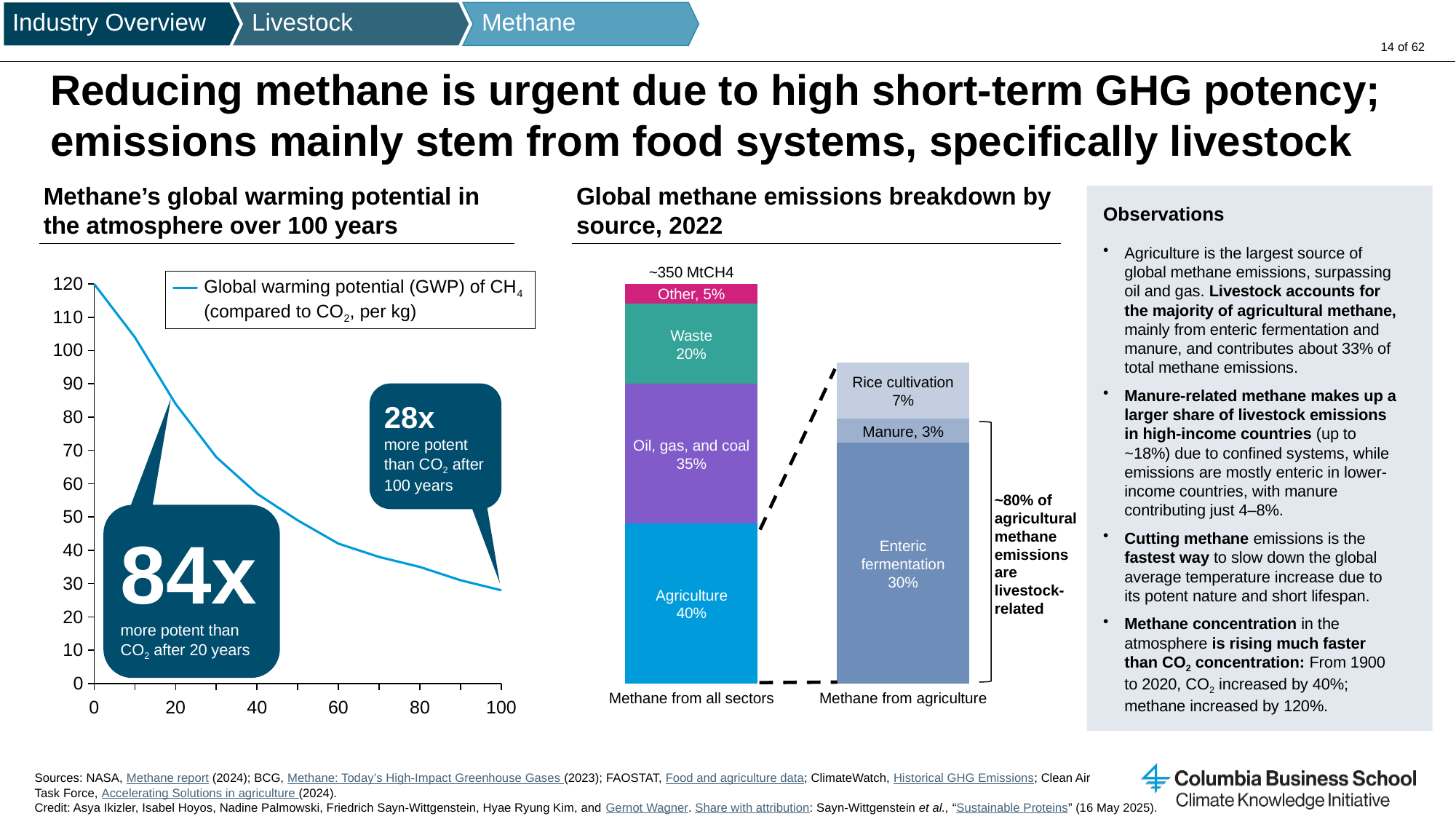
What kind of chart is the right chart, 'Global methane emissions breakdown by source, 2022'? Stacked bar chart In the right chart, which source is the largest segment of the 'Methane from all sectors' bar? Agriculture In the left chart, is the global warming potential at year 60 greater or less than 50? less In the right chart, what share of methane from all sectors comes from agriculture? 40% In the right chart, which is larger in the 'Methane from agriculture' bar: Rice cultivation or Manure? Rice cultivation What kind of chart is the left chart, 'Methane's global warming potential in the atmosphere over 100 years'? Line chart In the right chart, what is the difference in percentage points between Agriculture and Oil, gas, and coal in the 'Methane from all sectors' bar? 5 percentage points In the right chart, what is the total of the three segments in the 'Methane from agriculture' bar? 40% In the left chart, does the global warming potential of CH4 rise or fall as the years increase? Fall In the left chart, how many times more potent than CO2 is methane after 20 years? 84x In the left chart, how many times more potent than CO2 is methane after 100 years? 28x In the right chart, which source is the smallest segment of the 'Methane from all sectors' bar? Other